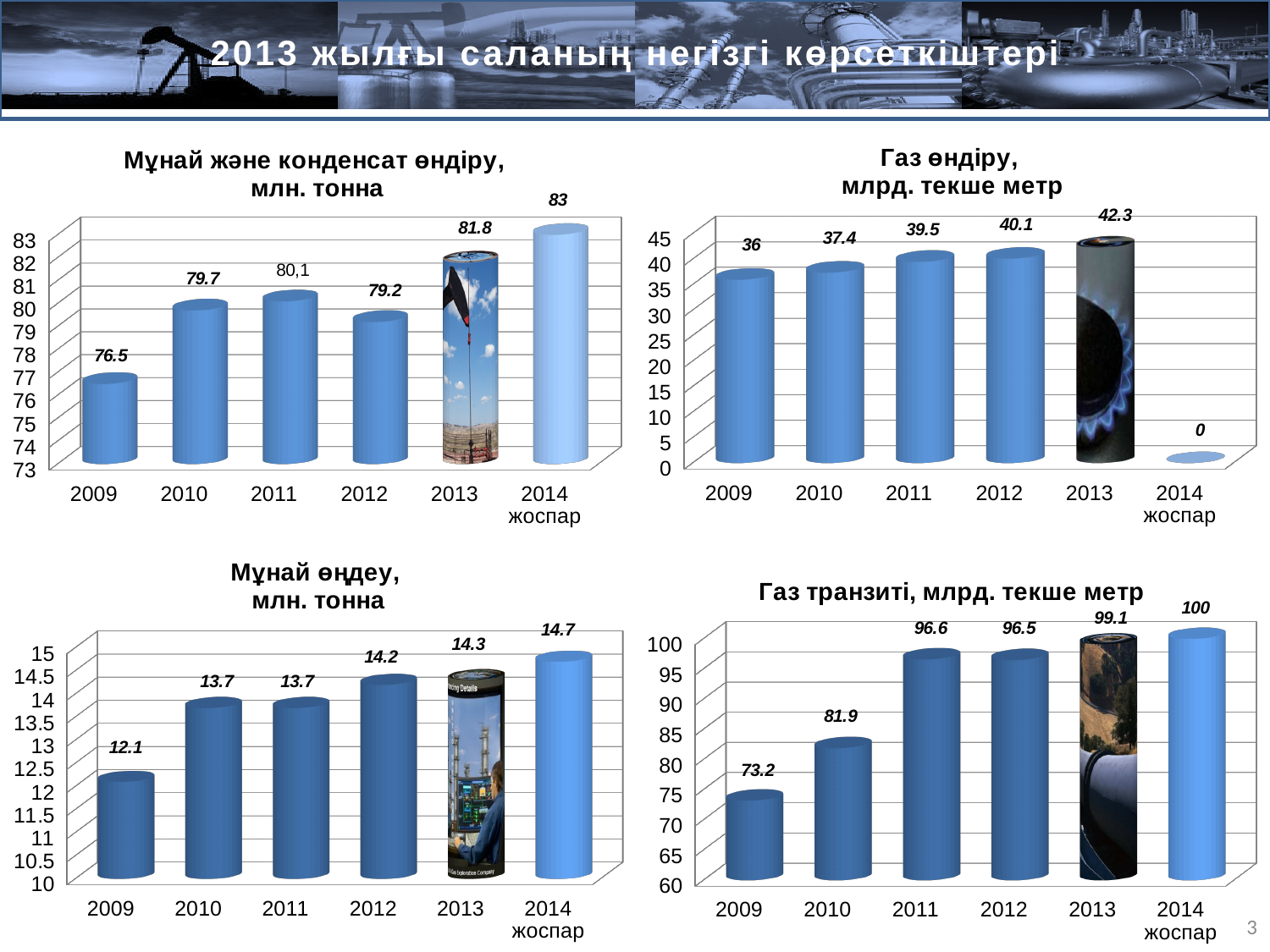
In the chart titled "Газ өндіру, млрд. текше метр", what is the value for 2013? 42.3 In the chart titled "Газ транзиті, млрд. текше метр", is the value for 2009 greater or less than 75? less In the chart titled "Мұнай өңдеу, млн. тонна", what is the difference between the 2014 жоспар value and the 2009 value? 2.6 In the chart titled "Газ өндіру, млрд. текше метр", what is the value shown for 2014 жоспар? 0 In the chart titled "Мұнай және конденсат өндіру, млн. тонна", what is the value for 2009? 76.5 In the chart titled "Мұнай өңдеу, млн. тонна", what is the value for 2012? 14.2 In the chart titled "Газ өндіру, млрд. текше метр", how many categories are shown on the x axis? 6 In the chart titled "Мұнай және конденсат өндіру, млн. тонна", what is the difference between the 2013 value and the 2012 value? 2.6 What kind of chart is the chart titled "Газ транзиті, млрд. текше метр"? bar chart In the chart titled "Мұнай өңдеу, млн. тонна", which year has the lowest value? 2009 In the chart titled "Мұнай және конденсат өндіру, млн. тонна", which year has the highest value? 2014 жоспар In the chart titled "Газ транзиті, млрд. текше метр", what is the value for 2010? 81.9